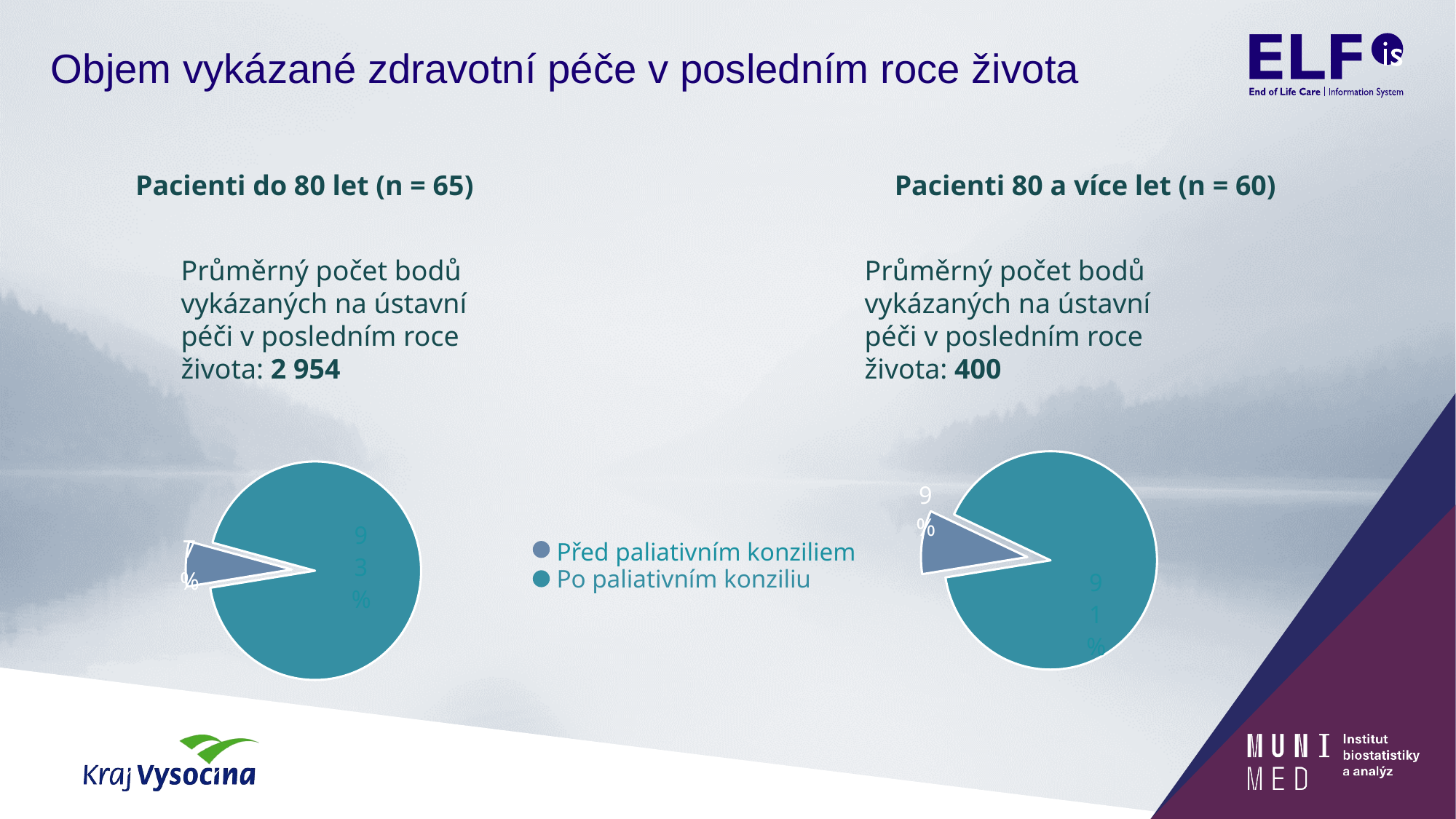
Which colour represents 'Po paliativním konziliu' in the legend? Teal What type of chart is used on the left for Pacienti do 80 let? Pie chart Which pie chart has the larger 'Před paliativním konziliem' slice, the left (Pacienti do 80 let) or the right (Pacienti 80 a více let)? Right (Pacienti 80 a více let) What is the difference between the 'Po paliativním konziliu' share in the left pie chart and the 'Po paliativním konziliu' share in the right pie chart? 2% In the right pie chart (Pacienti 80 a více let), what share is labelled for 'Před paliativním konziliem'? 9% How many entries does the shared legend list? 2 In the left pie chart (Pacienti do 80 let), which category has the largest slice? Po paliativním konziliu In the right pie chart (Pacienti 80 a více let), what share is labelled for 'Po paliativním konziliu'? 91% In the right pie chart (Pacienti 80 a více let), which category has the smallest slice? Před paliativním konziliem In the left pie chart (Pacienti do 80 let), what share is labelled for 'Po paliativním konziliu'? 93% In the left pie chart (Pacienti do 80 let), what share is labelled for 'Před paliativním konziliem'? 7% How many slices does the right pie chart (Pacienti 80 a více let) have? 2